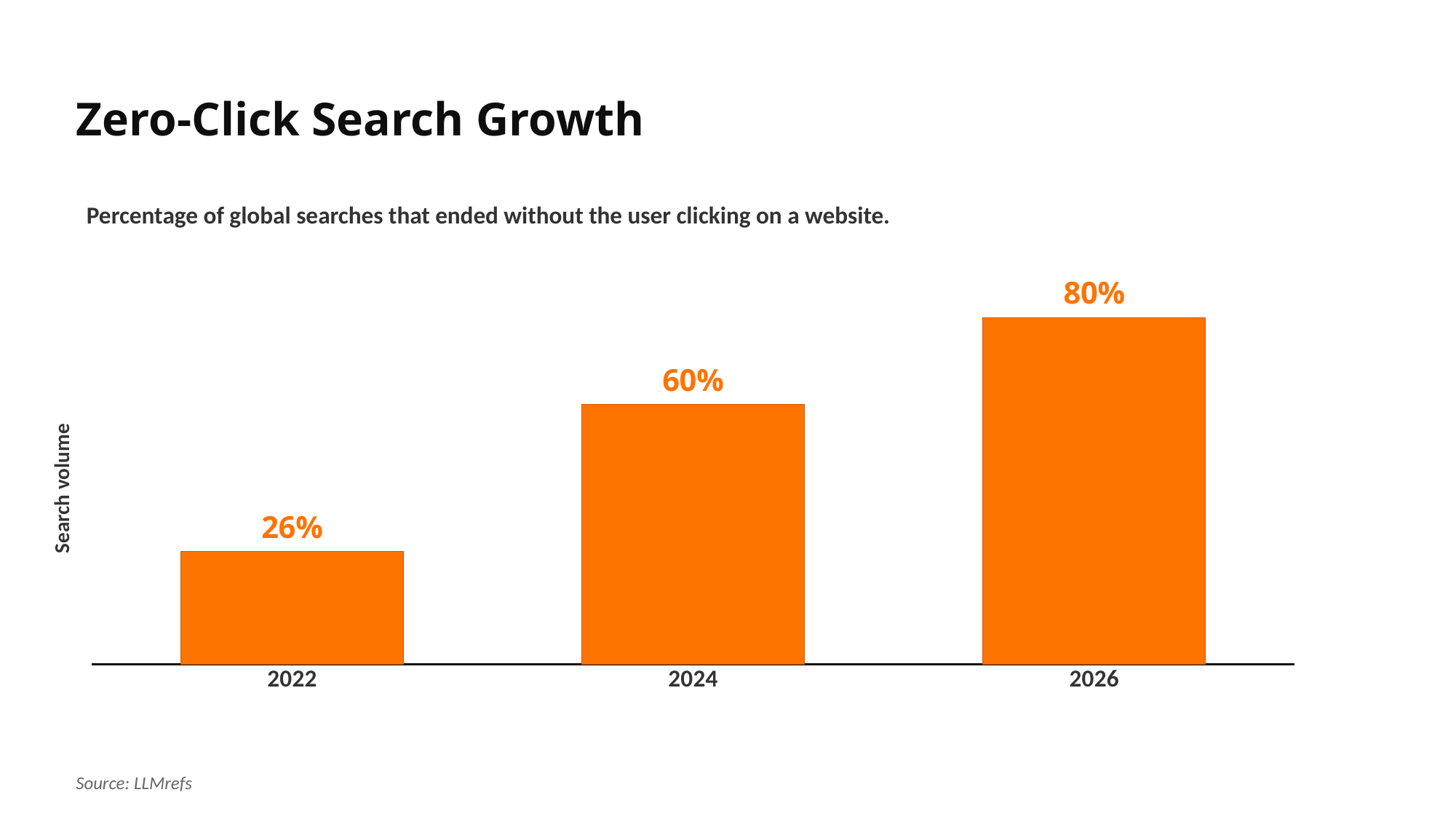
What is the title of the chart? Zero-Click Search Growth How many years are shown on the x axis? 3 What is the value for 2022? 26% Do the values rise or fall from 2022 to 2026? Rise Which is larger, the value for 2024 or the value for 2026? 2026 Which year has the lowest value? 2022 What is the value for 2024? 60% What is the difference between the values for 2024 and 2022? 34% Which year has the highest value? 2026 What kind of chart is this? Bar chart What is the value for 2026? 80% What is the difference between the values for 2026 and 2022? 54%